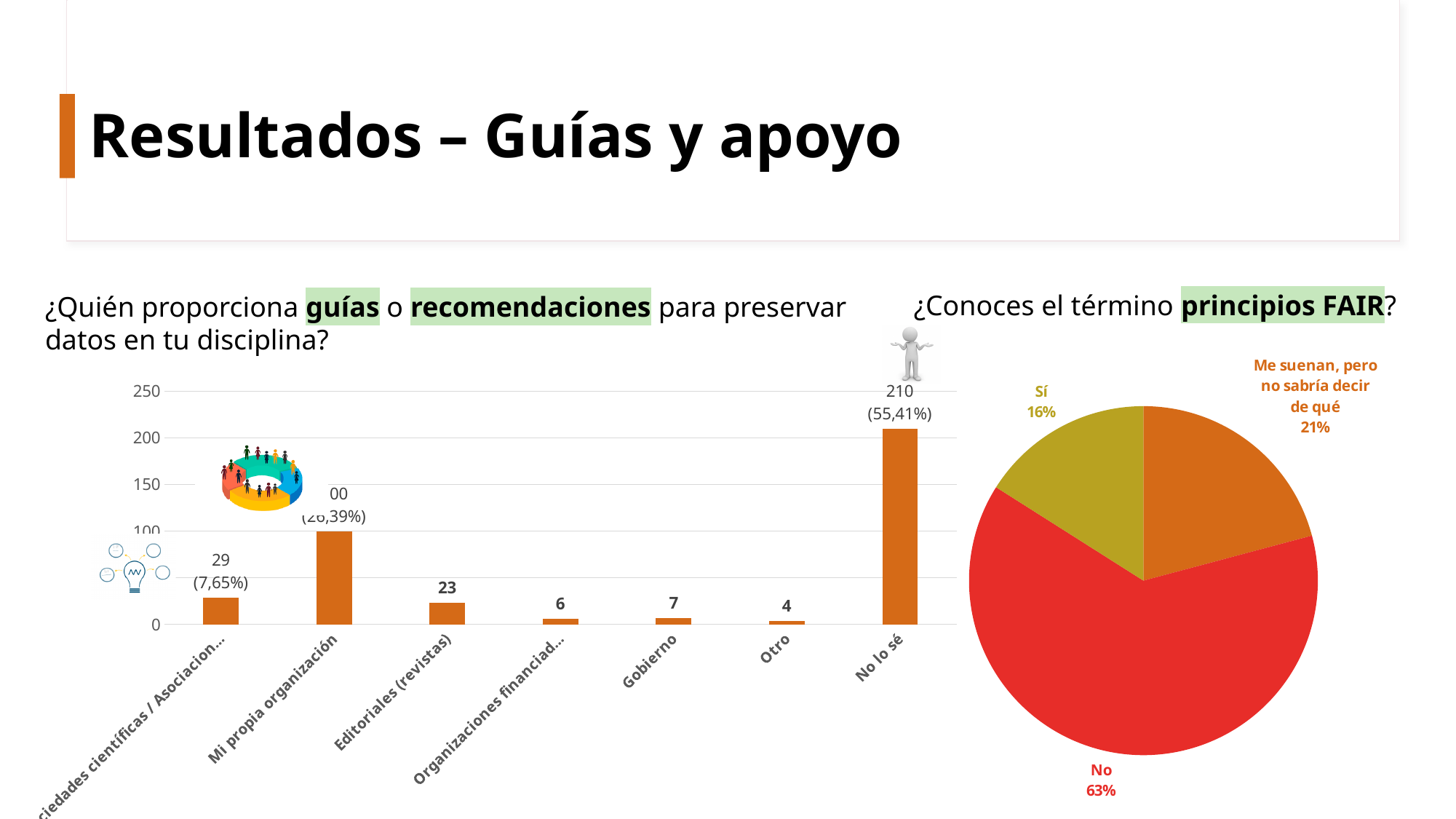
In the bar chart on the left, what is the value for 'Editoriales (revistas)'? 23 In the bar chart on the left, which category has the lowest value? Otro In the pie chart on the right, what share does 'No' have? 63% In the pie chart on the right, which slice is the smallest? Sí In the bar chart on the left, is the value for 'Mi propia organización' greater or less than 50? greater How many categories are shown in the bar chart on the left? 7 In the bar chart on the left, which category has the highest value? No lo sé In the bar chart on the left, what is the difference between the values for 'Gobierno' and 'Otro'? 3 In the bar chart on the left, which is larger: 'Editoriales (revistas)' or 'Gobierno'? Editoriales (revistas) In the bar chart on the left, what percentage is shown for 'No lo sé'? 55,41% In the bar chart on the left, what is the value for 'Gobierno'? 7 In the bar chart on the left, what is the value for 'No lo sé'? 210